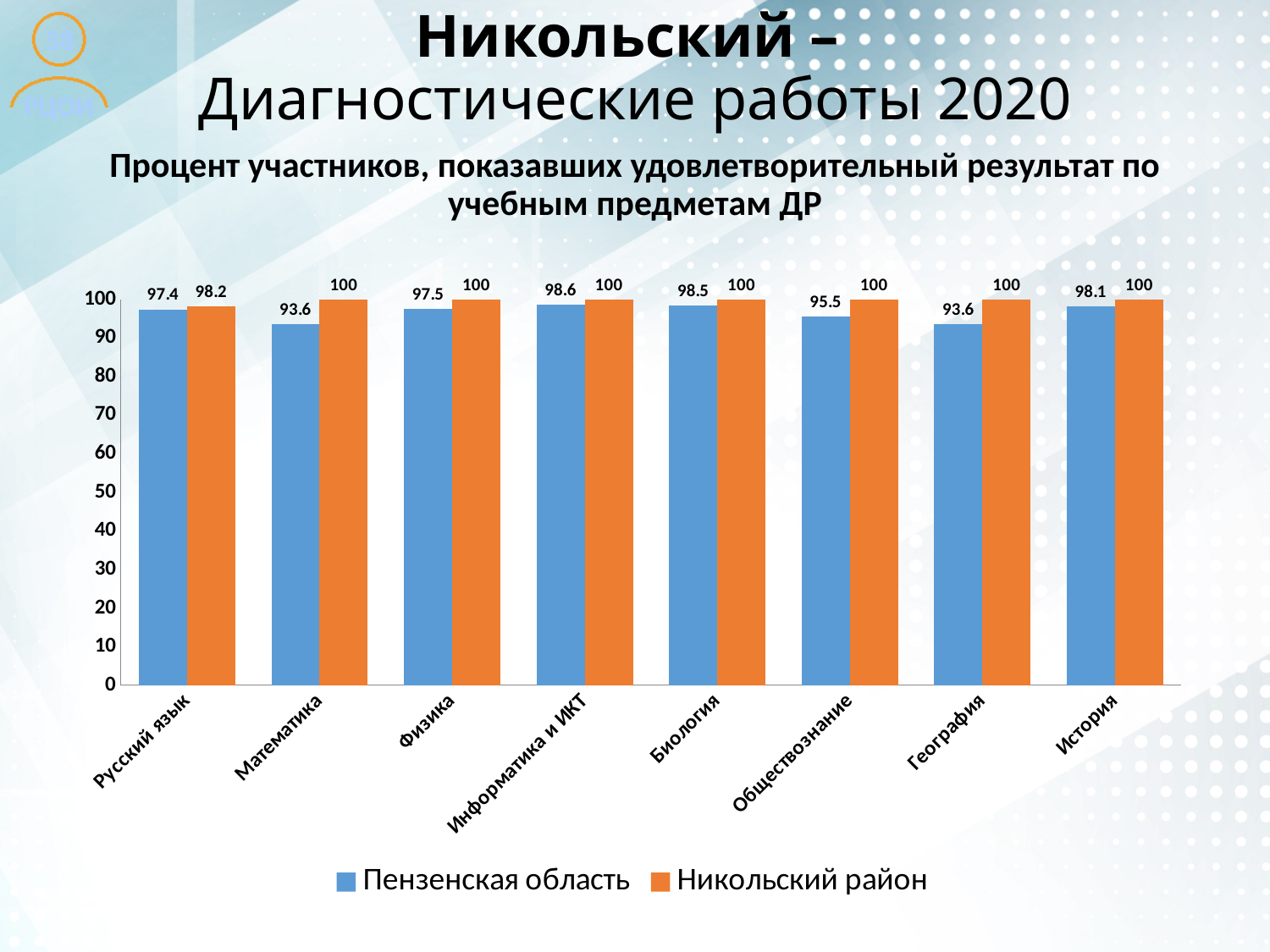
What is the value for Никольский район for Математика? 100 What is the value for Никольский район for Русский язык? 98.2 How many subjects (categories) are shown on the x axis? 8 Is the value for Пензенская область for Математика greater or less than 90? greater What type of chart is shown on the slide? bar chart Which is larger for Биология: the value for Пензенская область or for Никольский район? Никольский район Which series is shown in orange in the legend? Никольский район For which subject is the Никольский район value the lowest? Русский язык What is the difference between the Никольский район and Пензенская область values for География? 6.4 How many series does the legend list? 2 What is the value for Пензенская область for Обществознание? 95.5 What is the value for Пензенская область for Русский язык? 97.4